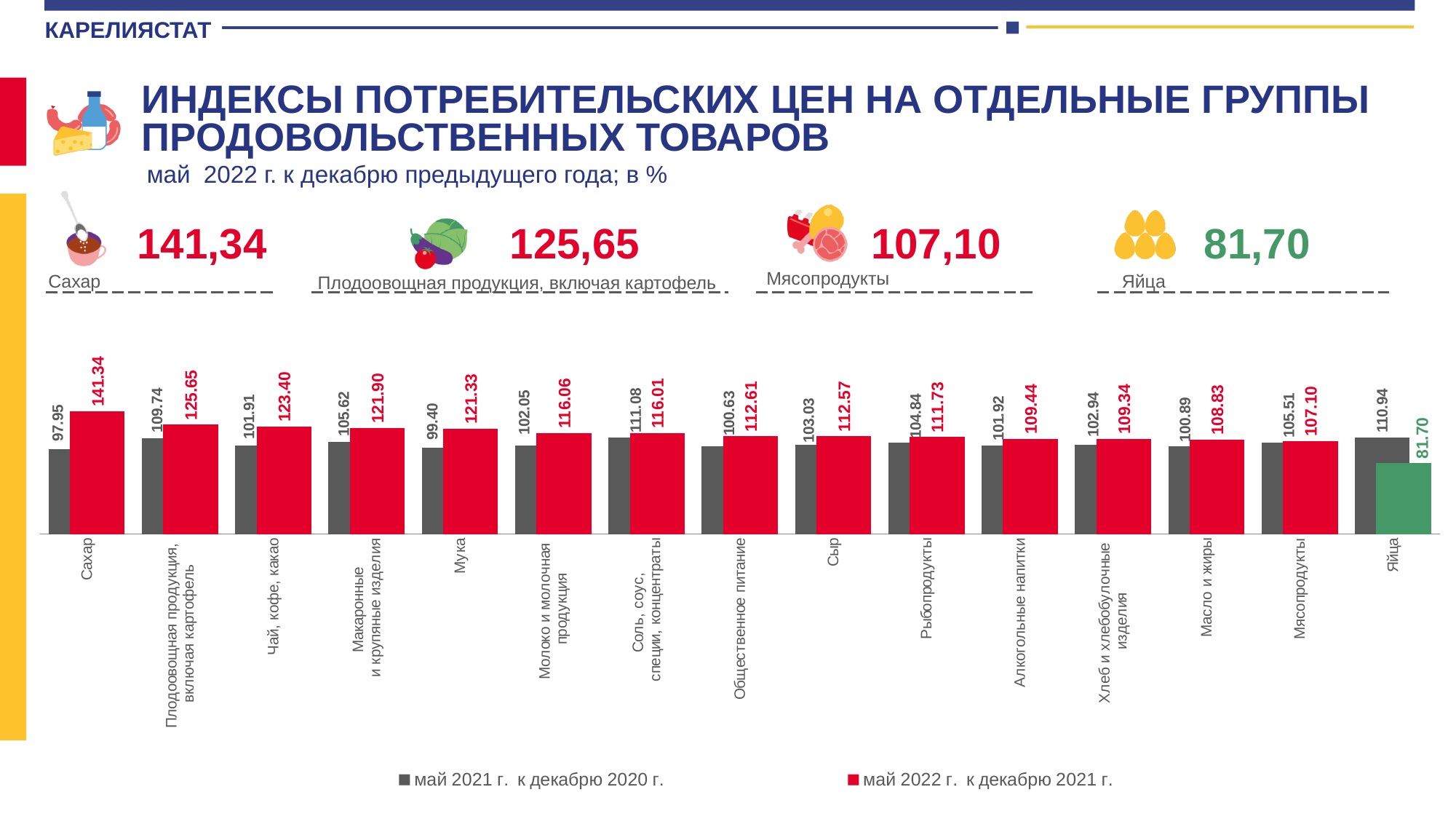
What is the value for Сахар in the series 'май 2022 г. к декабрю 2021 г.'? 141.34 What is the value for Мука in the series 'май 2021 г. к декабрю 2020 г.'? 99.40 What colour are the bars for the series 'май 2021 г. к декабрю 2020 г.'? grey What is the difference between the 'май 2022 г. к декабрю 2021 г.' and 'май 2021 г. к декабрю 2020 г.' values for Сахар? 43.39 How many product categories are shown on the x axis of the chart? 15 Which category has the highest value in the series 'май 2021 г. к декабрю 2020 г.'? Соль, соус, специи, концентраты What is the value for Яйца in the series 'май 2022 г. к декабрю 2021 г.'? 81.70 Which category has the lowest value in the series 'май 2022 г. к декабрю 2021 г.'? Яйца What type of chart is shown on the slide? bar chart For Яйца, which series has the larger value: 'май 2021 г. к декабрю 2020 г.' or 'май 2022 г. к декабрю 2021 г.'? май 2021 г. к декабрю 2020 г. Which category has the highest value in the series 'май 2022 г. к декабрю 2021 г.'? Сахар How many series does the chart legend list? 2